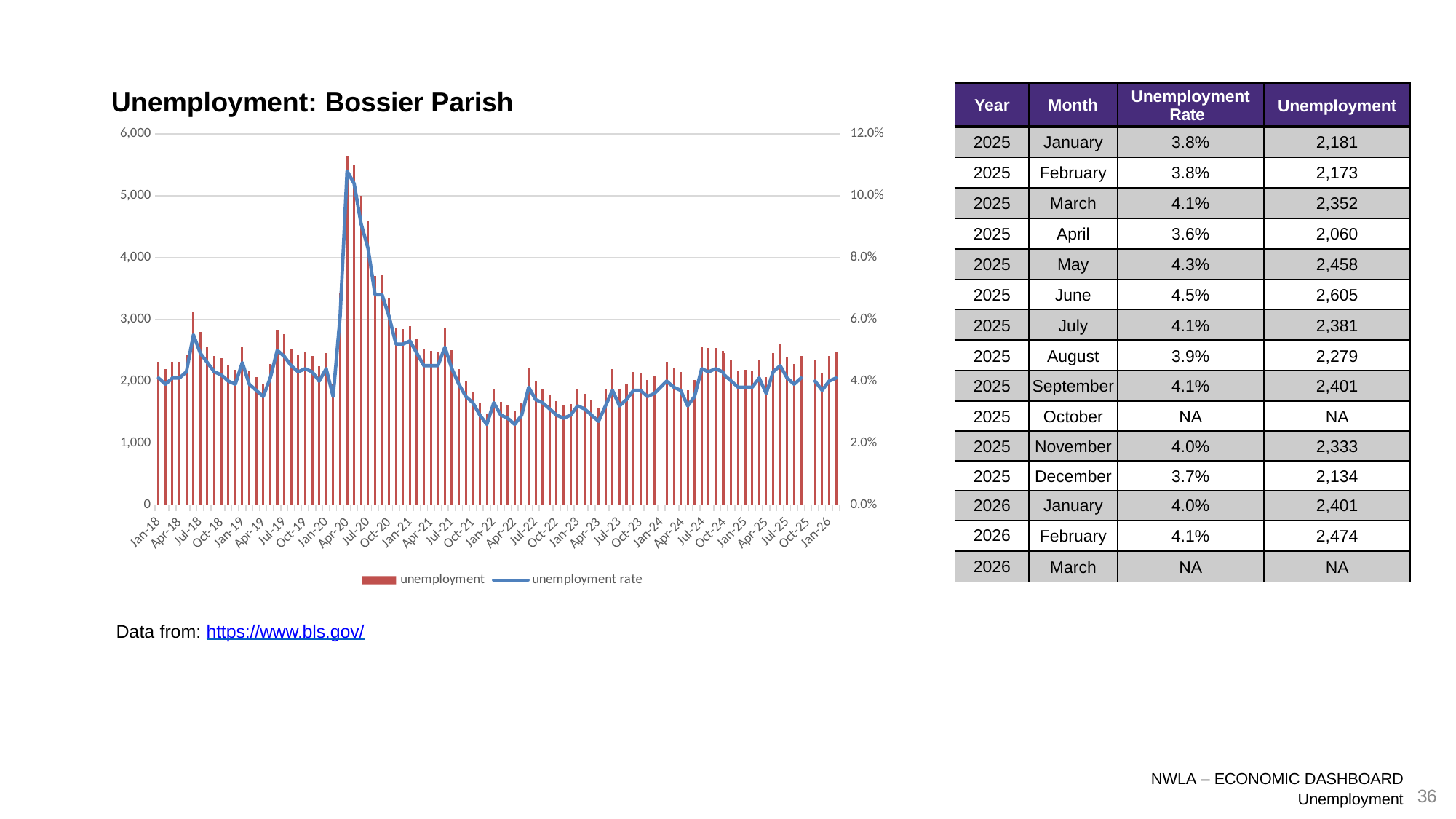
Is the unemployment rate for Jan-18 greater or less than 6.0%? less Is the unemployment rate line for Apr-20 greater or less than 10.0%? greater What kind of chart is shown on the slide? A bar chart combined with a line According to the table, what was the unemployment count in February 2026? 2,474 Using the table, what is the difference in unemployment between June 2025 and April 2025? 545 According to the table, what was the unemployment rate in June 2025? 4.5% Using the table, which month had the higher unemployment rate, May 2025 or July 2025? May 2025 What is the title of the chart? Unemployment: Bossier Parish Around which month does the unemployment bar reach its highest value? Apr-20 What are the two entries in the chart legend? unemployment and unemployment rate Is the unemployment bar for Apr-20 greater or less than 5,000? greater How many series does the chart legend list? 2